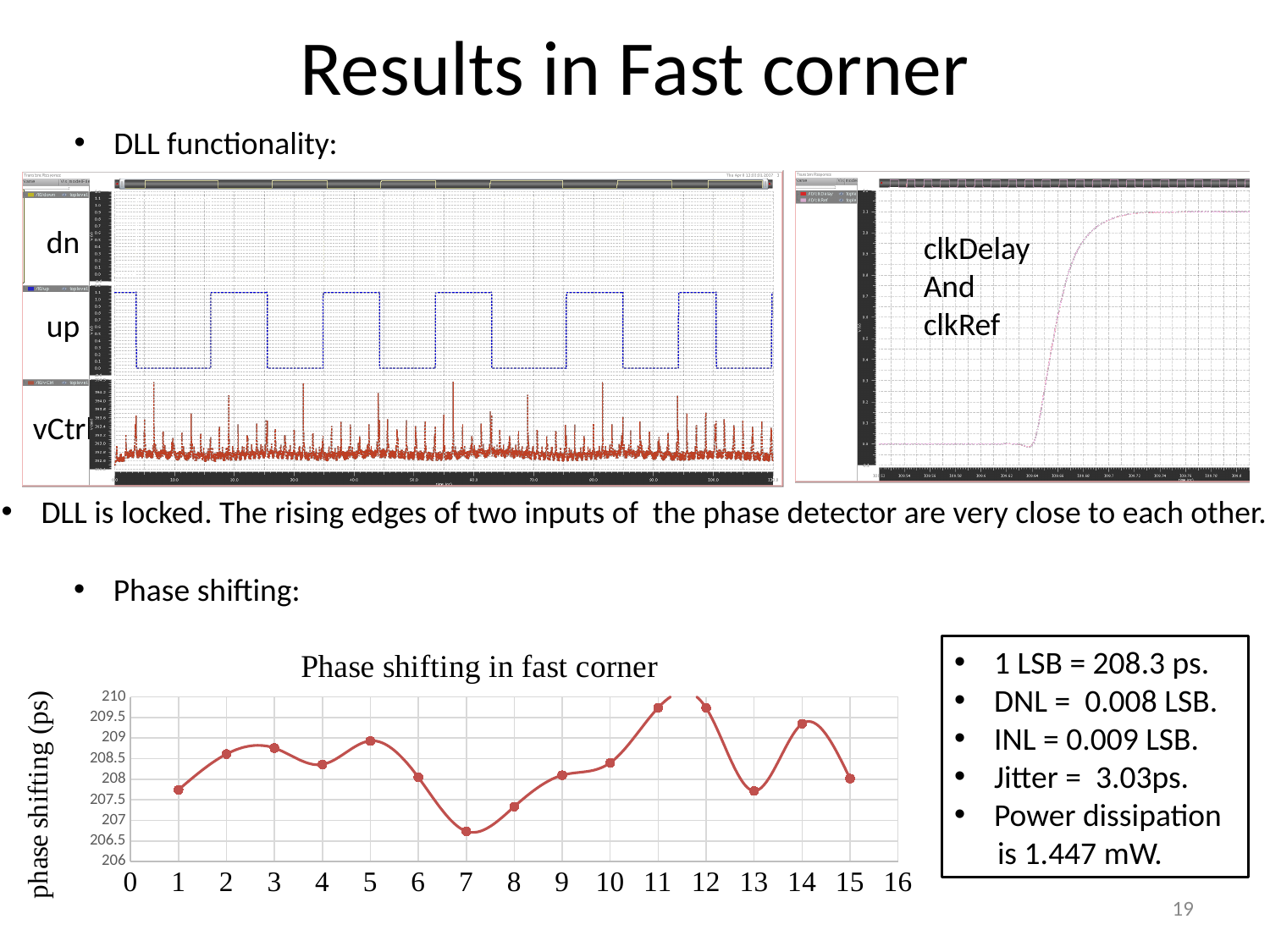
In the "Phase shifting in fast corner" chart, how many data points are plotted? 15 What kind of chart is "Phase shifting in fast corner"? line chart In the "Phase shifting in fast corner" chart, is the value at x = 7 greater or less than 207? less In the "Phase shifting in fast corner" chart, is the value at x = 11 greater or less than 209.5? greater In the "Phase shifting in fast corner" chart, at which x value is the phase shifting lowest? 7 In the "Phase shifting in fast corner" chart, do the values rise or fall from x = 7 to x = 11? rise In the "Phase shifting in fast corner" chart, which has the larger value, x = 7 or x = 11? 11 In the "Phase shifting in fast corner" chart, what is the label of the vertical axis? phase shifting (ps) In the "Phase shifting in fast corner" chart, is the value at x = 1 greater or less than 208? less What is the title of the chart at the bottom of the slide? Phase shifting in fast corner